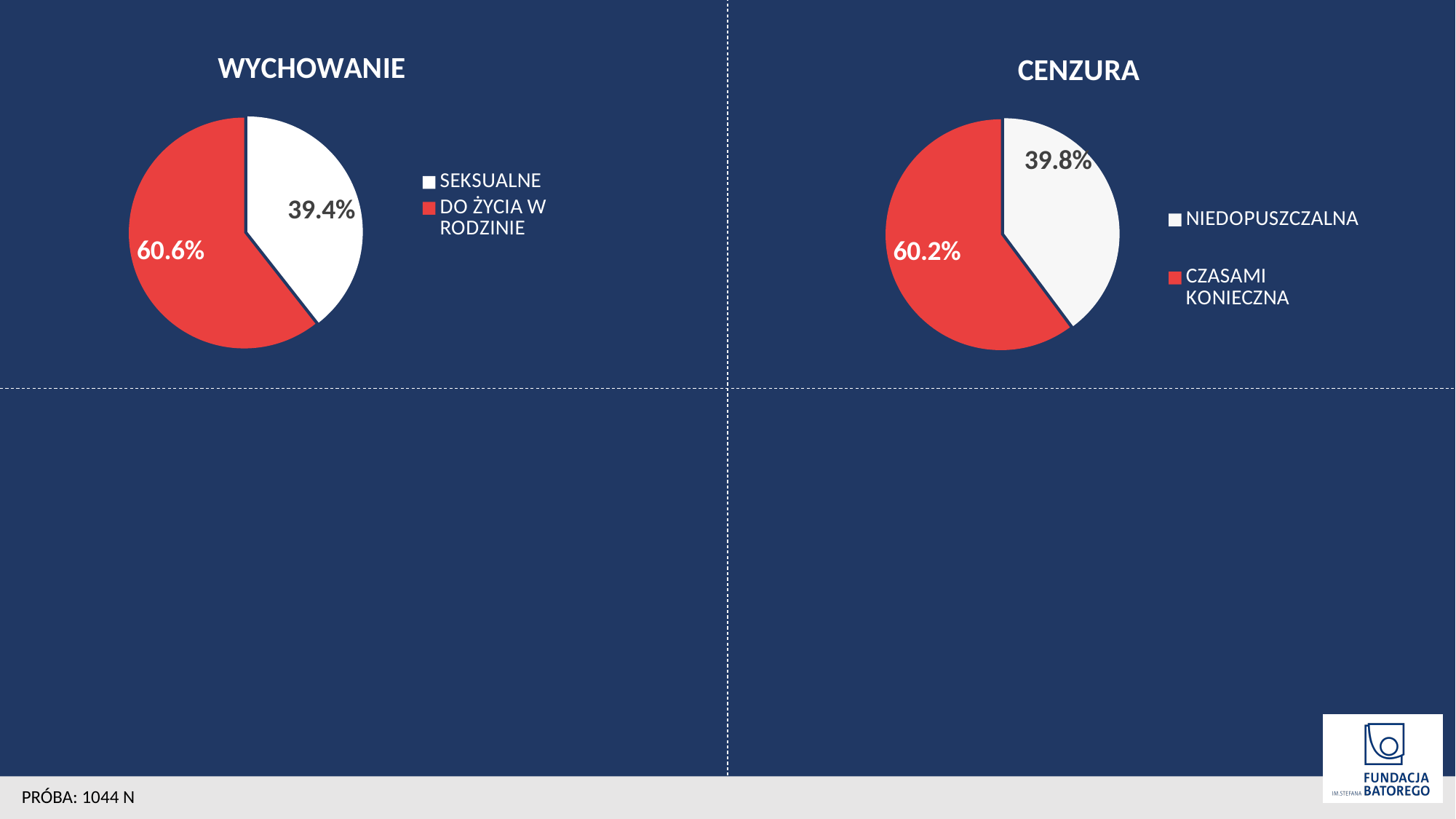
In the CENZURA chart, what share does the CZASAMI KONIECZNA slice have? 60.2% In the WYCHOWANIE chart, which slice is the largest? DO ŻYCIA W RODZINIE What kind of chart is the WYCHOWANIE chart? Pie chart In the WYCHOWANIE chart, what is the difference between the DO ŻYCIA W RODZINIE and SEKSUALNE shares? 21.2% In the CENZURA chart, what share does the NIEDOPUSZCZALNA slice have? 39.8% In the WYCHOWANIE chart, what share does the DO ŻYCIA W RODZINIE slice have? 60.6% In the CENZURA chart, what is the difference between the CZASAMI KONIECZNA and NIEDOPUSZCZALNA shares? 20.4% How many slices does the CENZURA chart have? 2 In the WYCHOWANIE chart, what colour is the DO ŻYCIA W RODZINIE slice? Red In the CENZURA chart, which slice is the smallest? NIEDOPUSZCZALNA In the WYCHOWANIE chart, what share does the SEKSUALNE slice have? 39.4% In the CENZURA chart, which is larger: CZASAMI KONIECZNA or NIEDOPUSZCZALNA? CZASAMI KONIECZNA